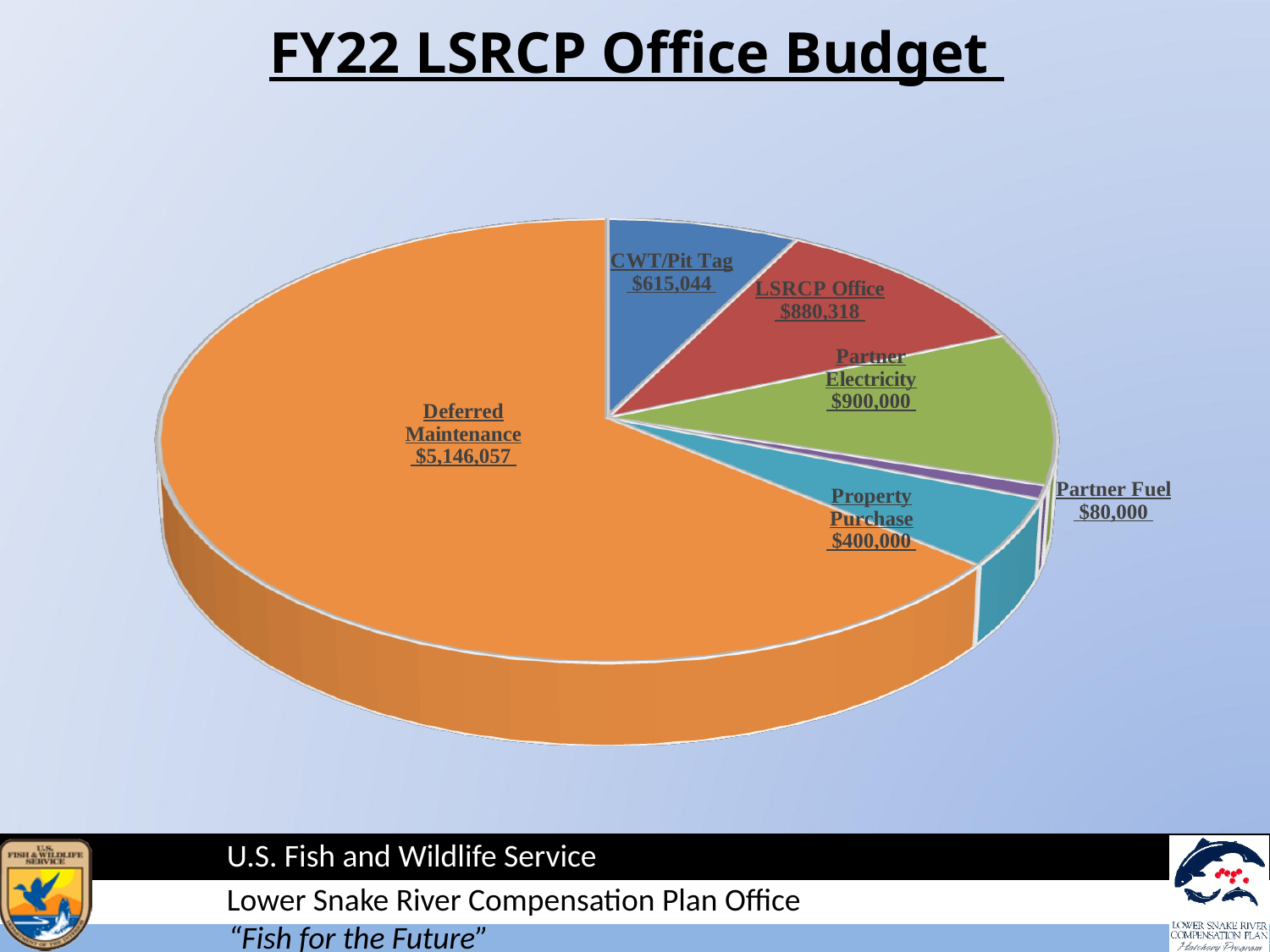
What colour is the Deferred Maintenance slice? Orange Which category has the largest slice of the pie? Deferred Maintenance What is the difference between Partner Electricity and Property Purchase? $500,000 Which category has the smallest slice of the pie? Partner Fuel What kind of chart is shown on the slide? Pie chart What is the value shown for Partner Fuel? $80,000 What is the value shown for LSRCP Office? $880,318 What is the value shown for CWT/Pit Tag? $615,044 What is the title of the chart? FY22 LSRCP Office Budget What is the value shown for Deferred Maintenance? $5,146,057 How many slices does the pie chart have? 6 Which is larger, Partner Electricity or LSRCP Office? Partner Electricity